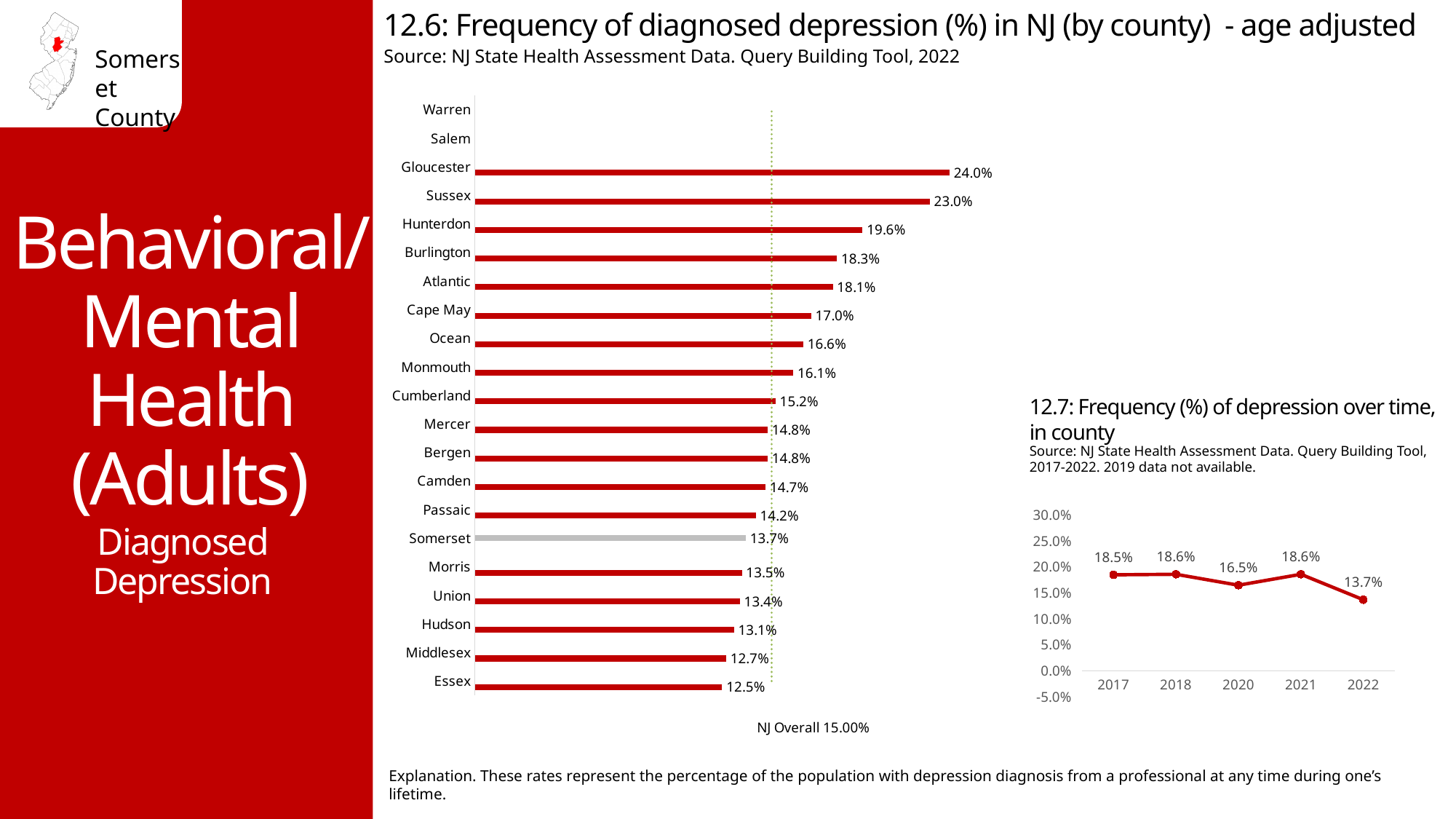
In chart 12.7, what is the difference between the 2021 and 2022 values? 4.9% In chart 12.6, what NJ overall value is shown by the dotted reference line? 15.00% In chart 12.6, which county has a higher value, Cape May or Ocean? Cape May In chart 12.7, how many years are plotted? 5 In chart 12.6, what is the frequency of diagnosed depression for Gloucester? 24.0% In chart 12.7, which year has the lowest frequency of depression? 2022 In chart 12.6, which county has the highest frequency of diagnosed depression? Gloucester What type of chart is chart 12.6? Bar chart In chart 12.6, what is the difference between the values for Sussex and Hunterdon? 3.4% In chart 12.6, what is the value shown for Somerset? 13.7% In chart 12.7, what is the frequency of depression in 2020? 16.5% In chart 12.6, which county with a plotted bar has the lowest frequency of diagnosed depression? Essex